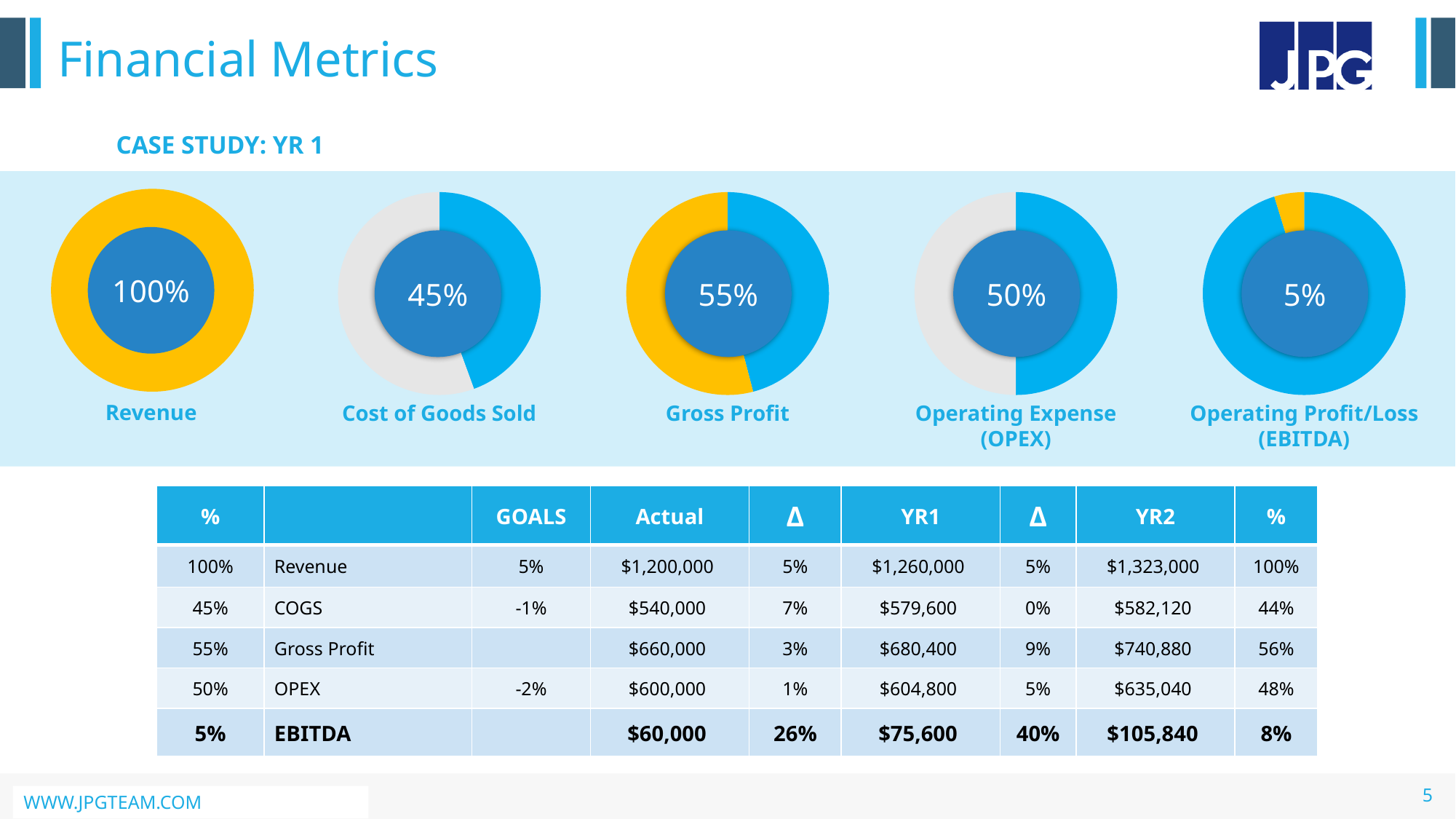
What is the difference between the Gross Profit percentage and the Operating Expense (OPEX) percentage shown in the donut charts? 5% How many donut charts are shown on the slide? 5 What percentage is shown in the centre of the Revenue donut chart? 100% What percentage is shown in the centre of the Operating Profit/Loss (EBITDA) donut chart? 5% What colour is the ring of the Revenue donut chart? Yellow Among the five donut charts, which metric shows the lowest percentage? Operating Profit/Loss (EBITDA) What percentage is shown in the centre of the Cost of Goods Sold donut chart? 45% Which is larger, the percentage in the Gross Profit donut chart or the percentage in the Cost of Goods Sold donut chart? Gross Profit What percentage is shown in the centre of the Gross Profit donut chart? 55% What percentage is shown in the centre of the Operating Expense (OPEX) donut chart? 50% What kind of chart is used to display the Cost of Goods Sold percentage? Donut chart Among the five donut charts, which metric shows the highest percentage? Revenue